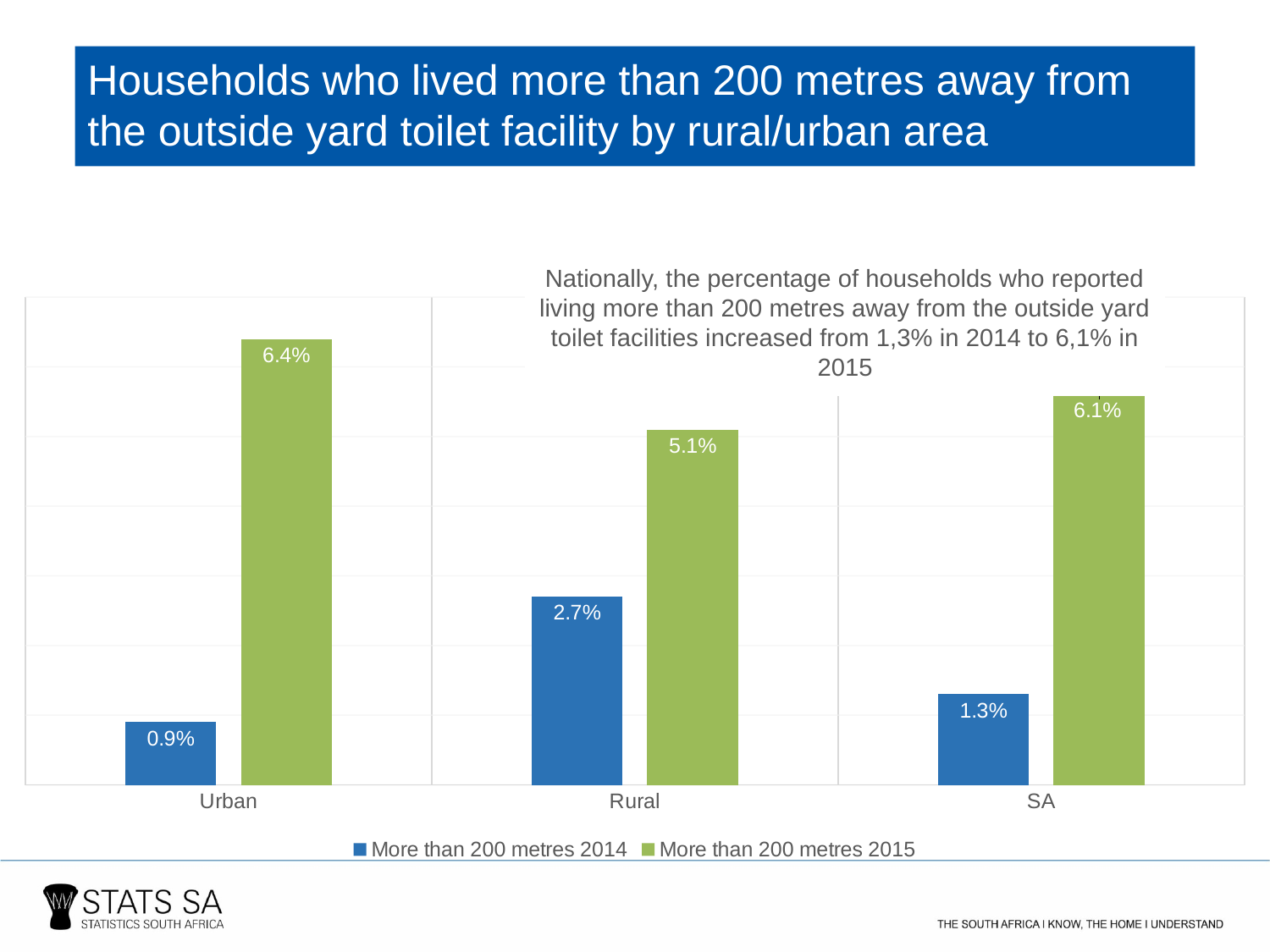
What is the difference between the 2015 and 2014 values for SA? 4.8% Which is larger: the 2014 value for Rural or the 2014 value for SA? Rural What is the difference between the 2015 and 2014 values for Urban? 5.5% What is the value for Rural in the 'More than 200 metres 2014' series? 2.7% Which category has the highest value in the 'More than 200 metres 2014' series? Rural Which colour represents the 'More than 200 metres 2015' series? Green What kind of chart is shown on the slide? Bar chart How many series does the legend list? 2 What is the value for Urban in the 'More than 200 metres 2015' series? 6.4% What is the value for SA in the 'More than 200 metres 2015' series? 6.1% How many categories are shown on the x axis? 3 Which category has the lowest value in the 'More than 200 metres 2015' series? Rural